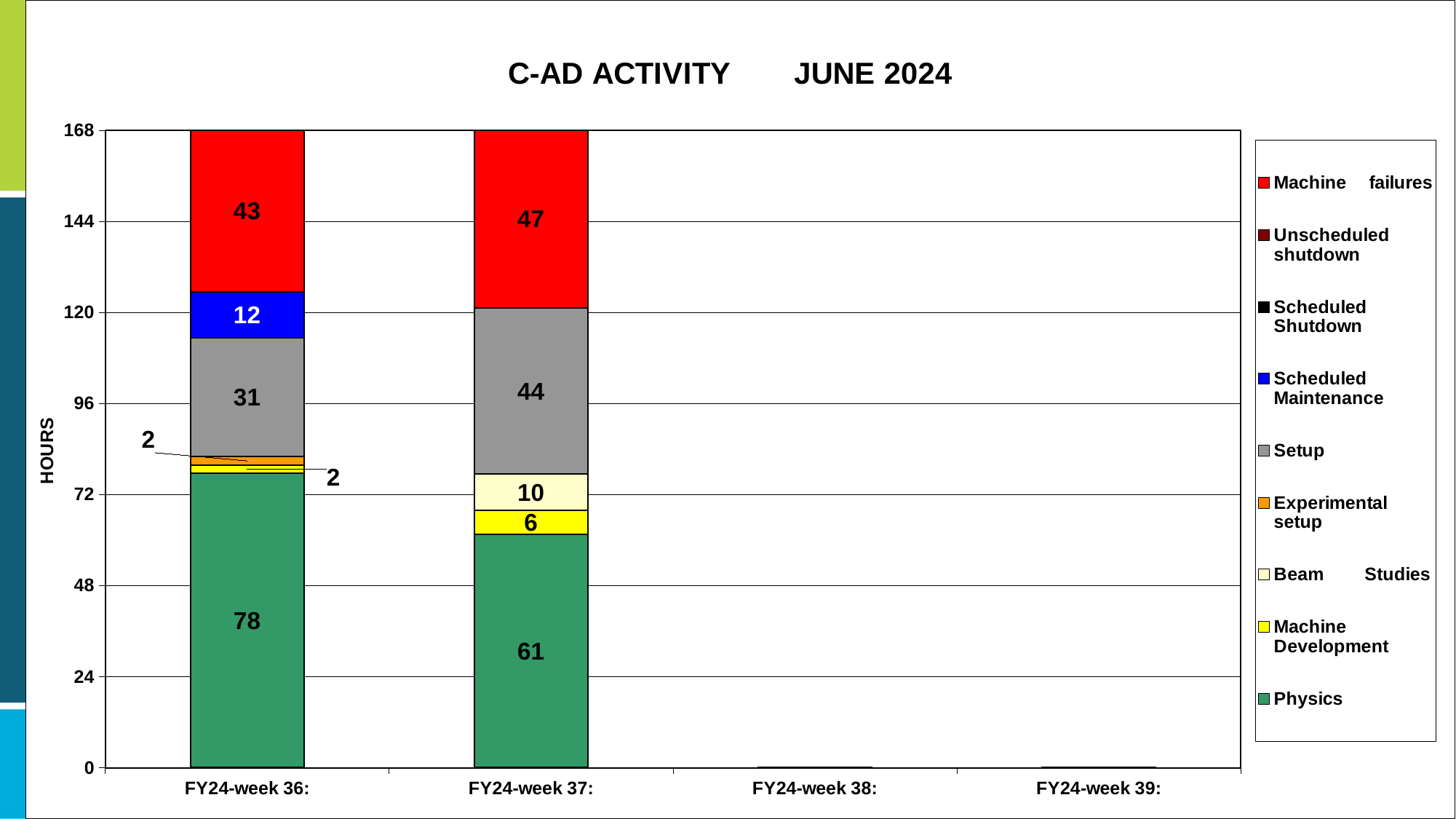
How many series does the legend list? 9 What is the Setup value for FY24-week 37? 44 What is the Scheduled Maintenance value for FY24-week 36? 12 What is the title of the chart? C-AD ACTIVITY JUNE 2024 Which week has the higher Physics value, FY24-week 36 or FY24-week 37? FY24-week 36 What is the Physics value for FY24-week 36? 78 What is the Beam Studies value for FY24-week 37? 10 What type of chart is shown on the slide? Stacked bar chart What is the difference between the Setup values for FY24-week 37 and FY24-week 36? 13 What is the Machine failures value for FY24-week 37? 47 What is the total of the stacked bar for FY24-week 37? 168 How many categories are shown on the x axis? 4